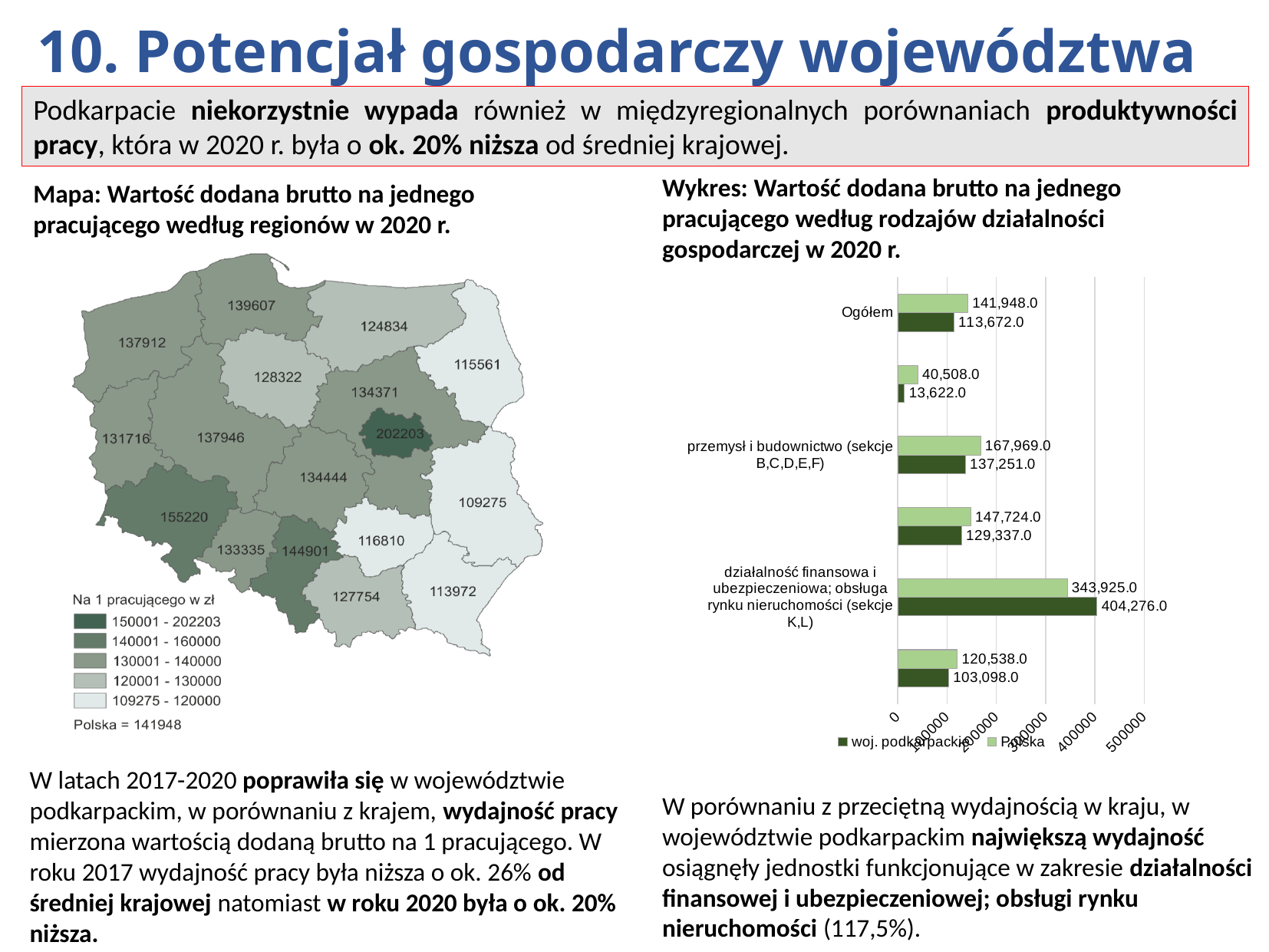
On the bar chart, what is the value for Polska in działalność finansowa i ubezpieczeniowa; obsługa rynku nieruchomości (sekcje K,L)? 343,925.0 On the bar chart, in działalność finansowa i ubezpieczeniowa; obsługa rynku nieruchomości (sekcje K,L), which series has the larger value, woj. podkarpackie or Polska? woj. podkarpackie On the bar chart, what is the difference between the Polska and woj. podkarpackie values in the Ogółem category? 28,276.0 On the bar chart, is the woj. podkarpackie value for działalność finansowa i ubezpieczeniowa; obsługa rynku nieruchomości (sekcje K,L) greater or less than 400000? greater How many series does the legend of the bar chart list? 2 On the bar chart, what is the value for Polska in the Ogółem category? 141,948.0 What kind of chart is shown on the right side of the slide? bar chart On the bar chart, in przemysł i budownictwo (sekcje B,C,D,E,F), which series has the larger value, woj. podkarpackie or Polska? Polska On the bar chart, what is the value for woj. podkarpackie in the Ogółem category? 113,672.0 On the bar chart, what is the value for woj. podkarpackie in przemysł i budownictwo (sekcje B,C,D,E,F)? 137,251.0 On the bar chart, which series is drawn in dark green? woj. podkarpackie On the bar chart, in which category does woj. podkarpackie reach its highest value? działalność finansowa i ubezpieczeniowa; obsługa rynku nieruchomości (sekcje K,L)